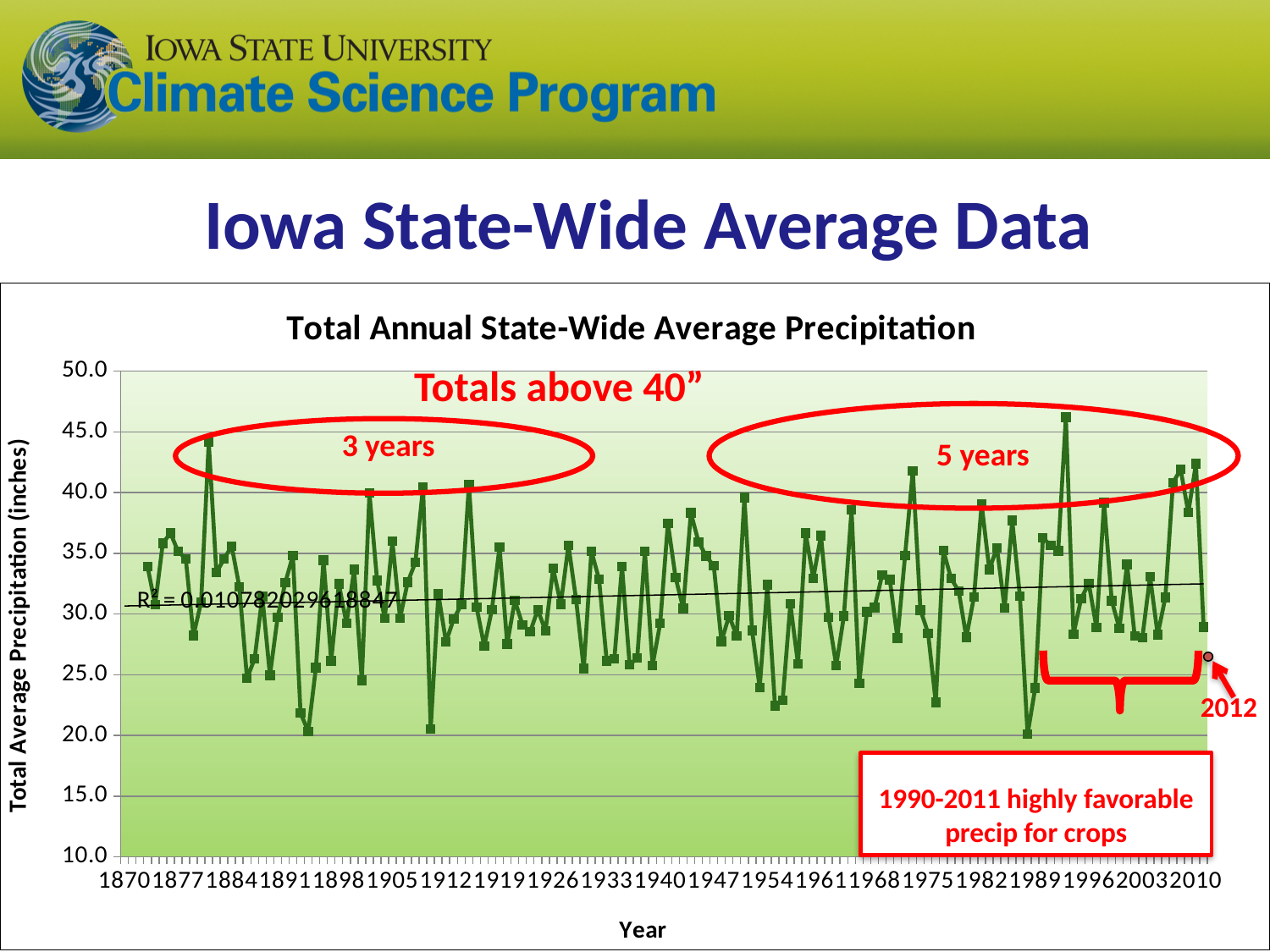
Is the fitted trend line on the chart roughly flat, strongly rising, or strongly falling across the years? roughly flat Is the lowest value plotted on the chart greater or less than 25? less What kind of chart is shown on the slide? line chart Is the value for 2012, marked with a circle on the chart, greater or less than 30? less What is the label of the y-axis of the chart? Total Average Precipitation (inches) What is the first year labeled on the x-axis of the chart? 1870 According to the annotation, how many years in the early circled period had totals above 40 inches? 3 years What is the title of the chart? Total Annual State-Wide Average Precipitation How many year labels are printed along the x-axis of the chart? 21 According to the annotation, how many years in the later circled period had totals above 40 inches? 5 years Is the highest value plotted on the chart greater or less than 40? greater Which period does the text box describe as highly favorable precip for crops? 1990-2011